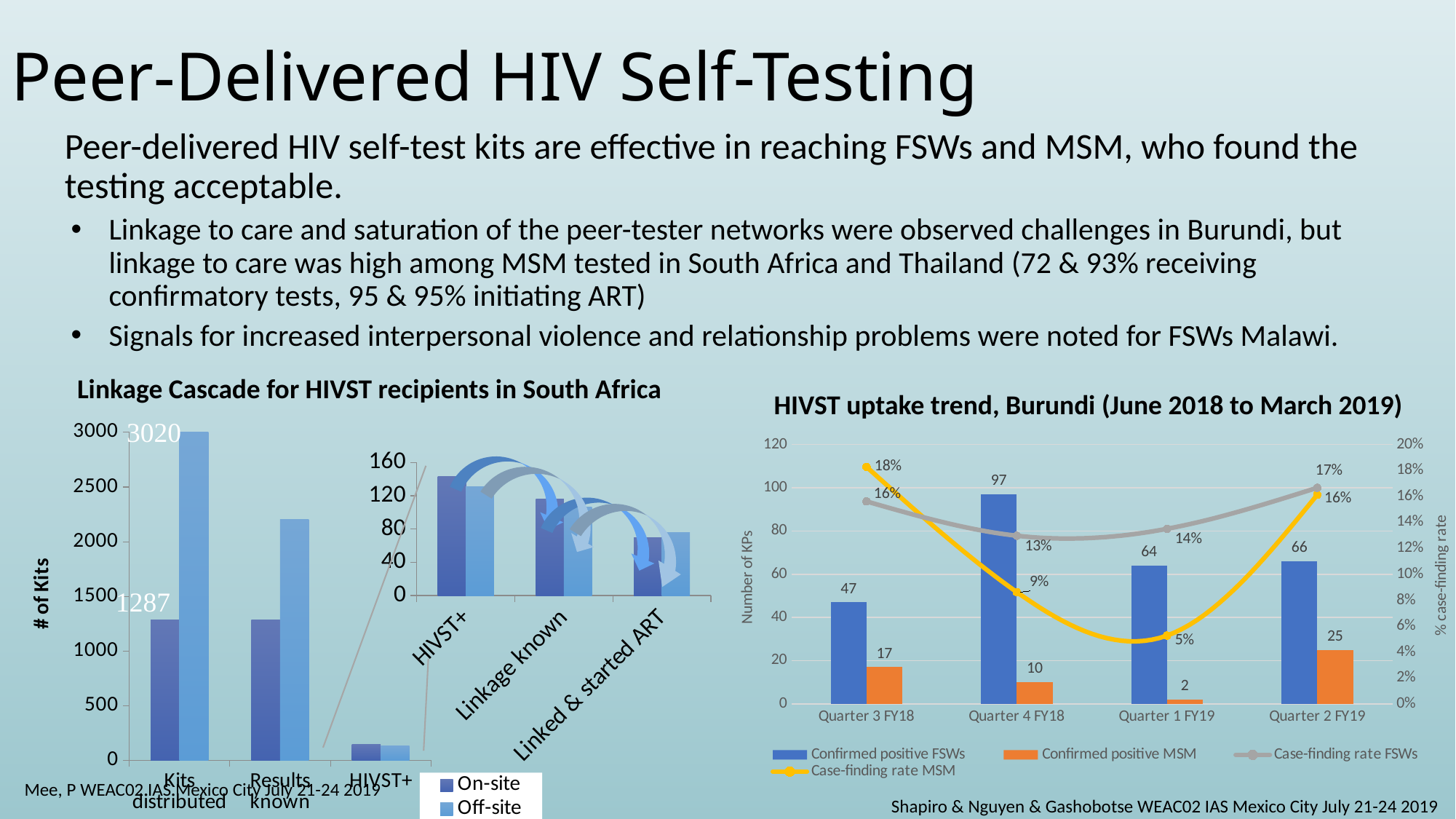
How many series does the legend of the 'HIVST uptake trend, Burundi' chart list? 4 In the 'HIVST uptake trend, Burundi' chart, how many confirmed positive FSWs were there in Quarter 4 FY18? 97 In the 'HIVST uptake trend, Burundi' chart, which is larger in Quarter 4 FY18: the case-finding rate for FSWs or for MSM? Case-finding rate FSWs In the 'Linkage Cascade for HIVST recipients in South Africa' chart, how many kits were distributed on-site? 1287 In the 'Linkage Cascade for HIVST recipients in South Africa' chart, is the Off-site value for Results known greater or less than 2000? greater In the 'HIVST uptake trend, Burundi' chart, what is the difference between confirmed positive FSWs and confirmed positive MSM in Quarter 2 FY19? 41 In the 'HIVST uptake trend, Burundi' chart, which quarter has the lowest case-finding rate for MSM? Quarter 1 FY19 In the 'Linkage Cascade for HIVST recipients in South Africa' chart, how many kits were distributed off-site? 3020 How many quarters are shown on the x axis of the 'HIVST uptake trend, Burundi' chart? 4 In the 'HIVST uptake trend, Burundi' chart, what is the case-finding rate for MSM in Quarter 3 FY18? 18% In the 'HIVST uptake trend, Burundi' chart, how many confirmed positive MSM were there in Quarter 1 FY19? 2 In the 'HIVST uptake trend, Burundi' chart, which quarter has the highest number of confirmed positive FSWs? Quarter 4 FY18